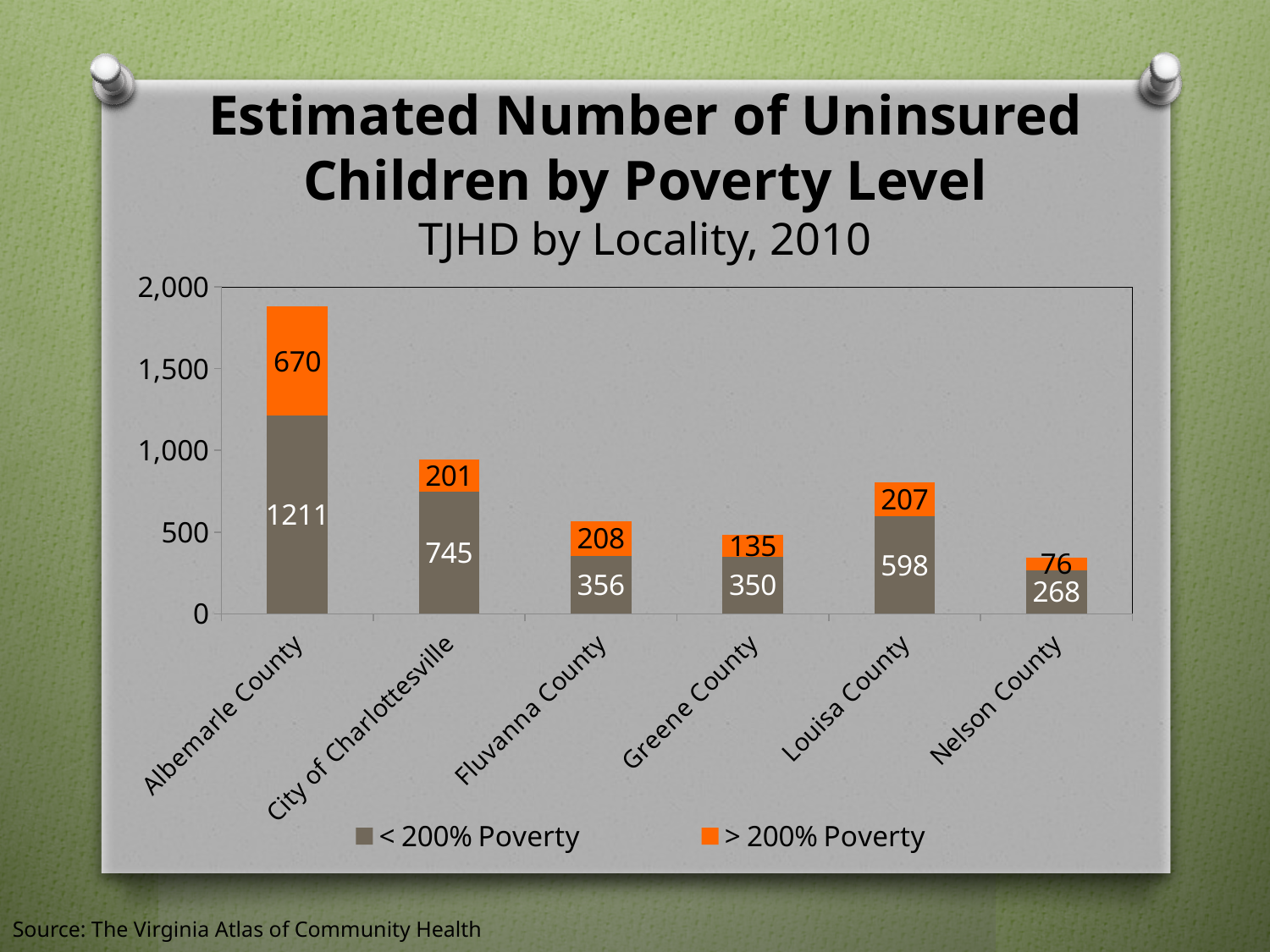
Which locality has the highest value for < 200% Poverty? Albemarle County What kind of chart is shown on the slide? Stacked bar chart What is the total of the stacked bar for Greene County? 485 What is the value for > 200% Poverty in Louisa County? 207 Which locality has the lowest value for > 200% Poverty? Nelson County How many series does the legend list? 2 Which is larger: the > 200% Poverty value for Fluvanna County or for Greene County? Fluvanna County What is the value for < 200% Poverty in Albemarle County? 1211 What is the difference between the < 200% Poverty values for City of Charlottesville and Louisa County? 147 What is the value for < 200% Poverty in Nelson County? 268 What is the total of the stacked bar for Albemarle County? 1881 How many localities are shown on the x axis? 6